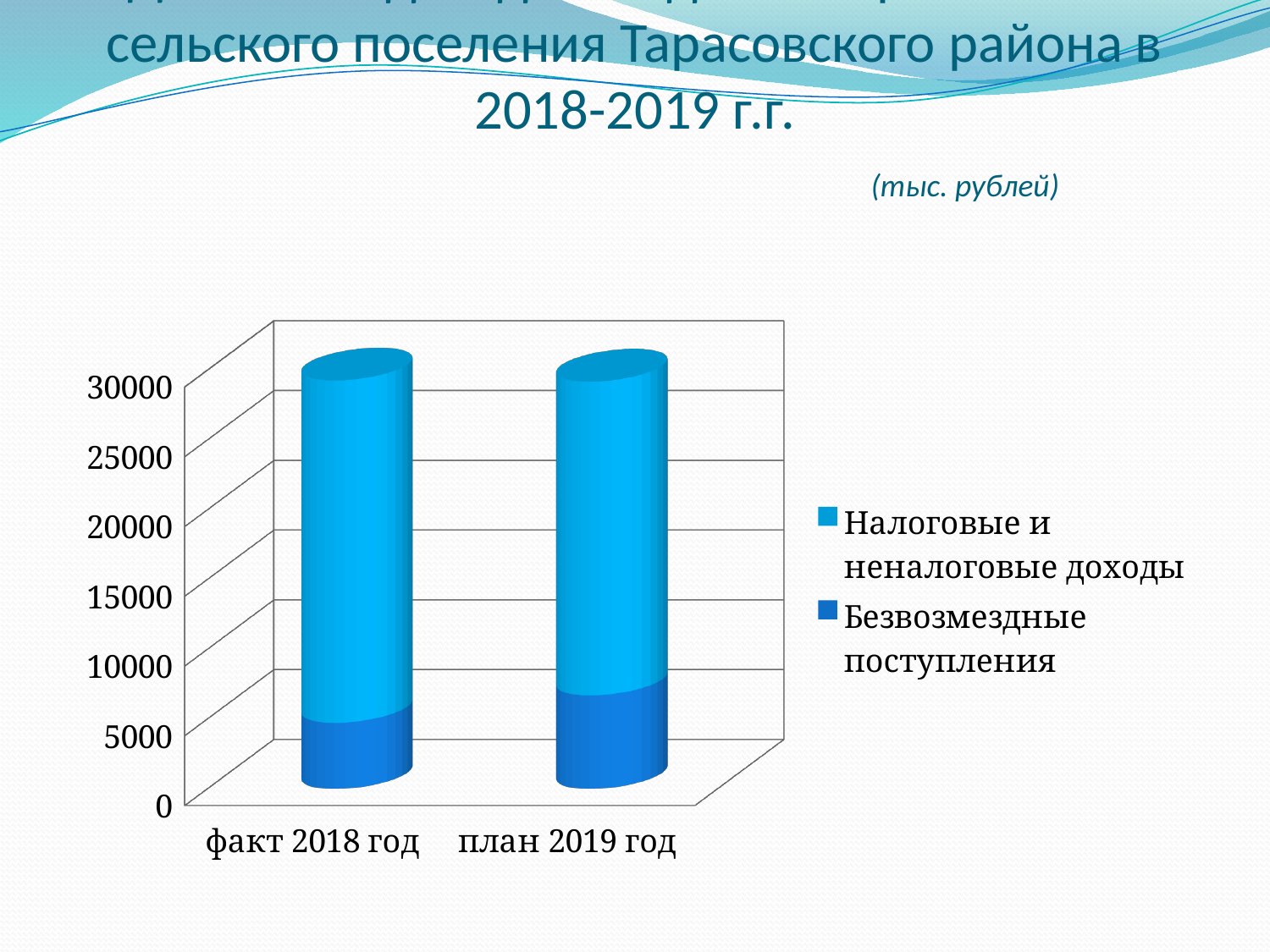
Is the total height of the stacked bar for план 2019 год greater or less than 25000? greater Which category has the larger value for Безвозмездные поступления: факт 2018 год or план 2019 год? план 2019 год Is the value of Безвозмездные поступления for план 2019 год greater or less than 5000? greater Does the value of Безвозмездные поступления rise or fall from факт 2018 год to план 2019 год? rises How many categories are shown on the x axis of the chart? 2 Is the value of Безвозмездные поступления for план 2019 год greater or less than 10000? less What kind of chart is shown on the slide? bar chart In what units are the chart values given, according to the slide? тыс. рублей What are the two series named in the chart legend? Налоговые и неналоговые доходы; Безвозмездные поступления How many series does the chart legend list? 2